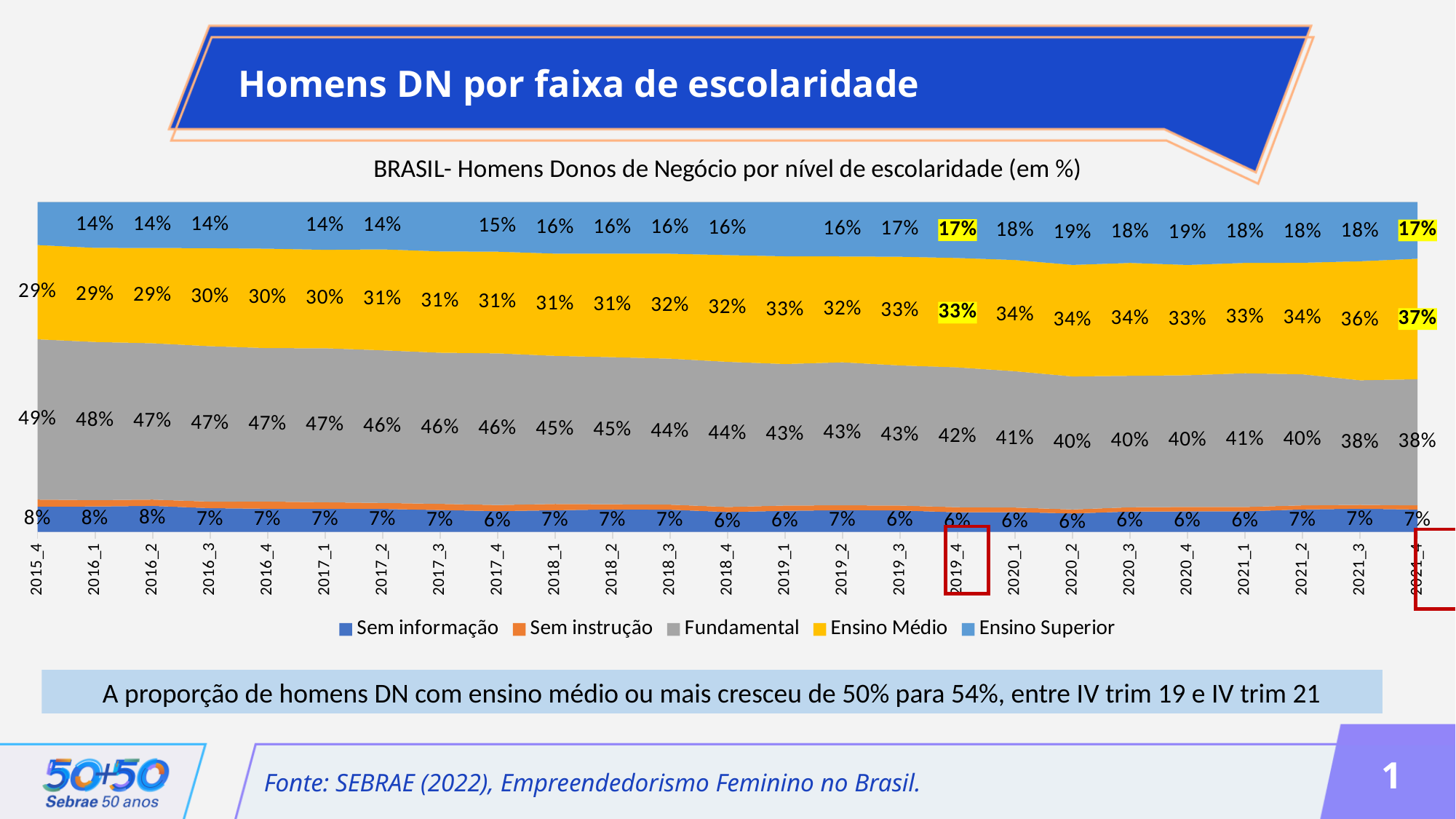
Does the Fundamental share rise or fall from 2015_4 to 2021_4? Fall What is the difference between the Fundamental value in 2015_4 and in 2021_4? 11 percentage points What is the difference between the Ensino Médio value in 2021_4 and in 2019_4? 4 percentage points What type of chart is shown on the slide? Stacked area chart In which quarter is the Ensino Médio value highest? 2021_4 What is the value for Fundamental in 2015_4? 49% How many series does the legend list? 5 In which quarter is the Fundamental value highest? 2015_4 What is the value for Ensino Médio in 2021_4? 37% What is the value for Ensino Superior in 2019_4? 17% What is the value for Sem informação in 2016_2? 8% In 2021_4, which is larger: Fundamental or Ensino Médio? Fundamental